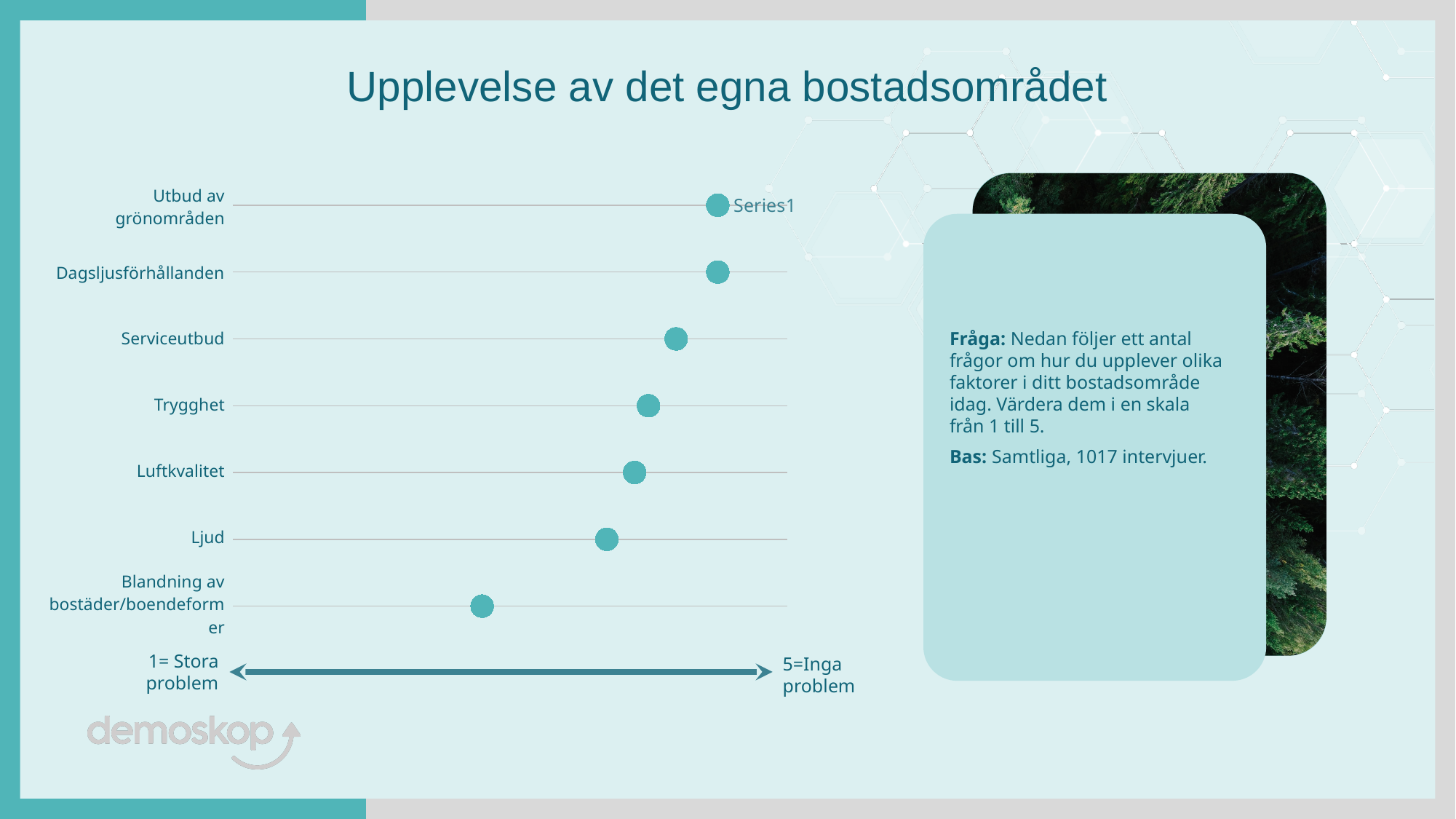
What does the value 5 on the scale represent according to the axis label? Inga problem How many categories are plotted in the chart? 7 Which category has the lowest value in the chart? Blandning av bostäder/boendeformer Which has the higher value, Dagsljusförhållanden or Serviceutbud? Dagsljusförhållanden Which has the higher value, Ljud or Luftkvalitet? Luftkvalitet Do the plotted values increase or decrease going from the top category to the bottom category? Decrease What is the title of the chart? Upplevelse av det egna bostadsområdet What kind of chart is shown on the slide? Dot plot Which has the higher value, Serviceutbud or Trygghet? Serviceutbud